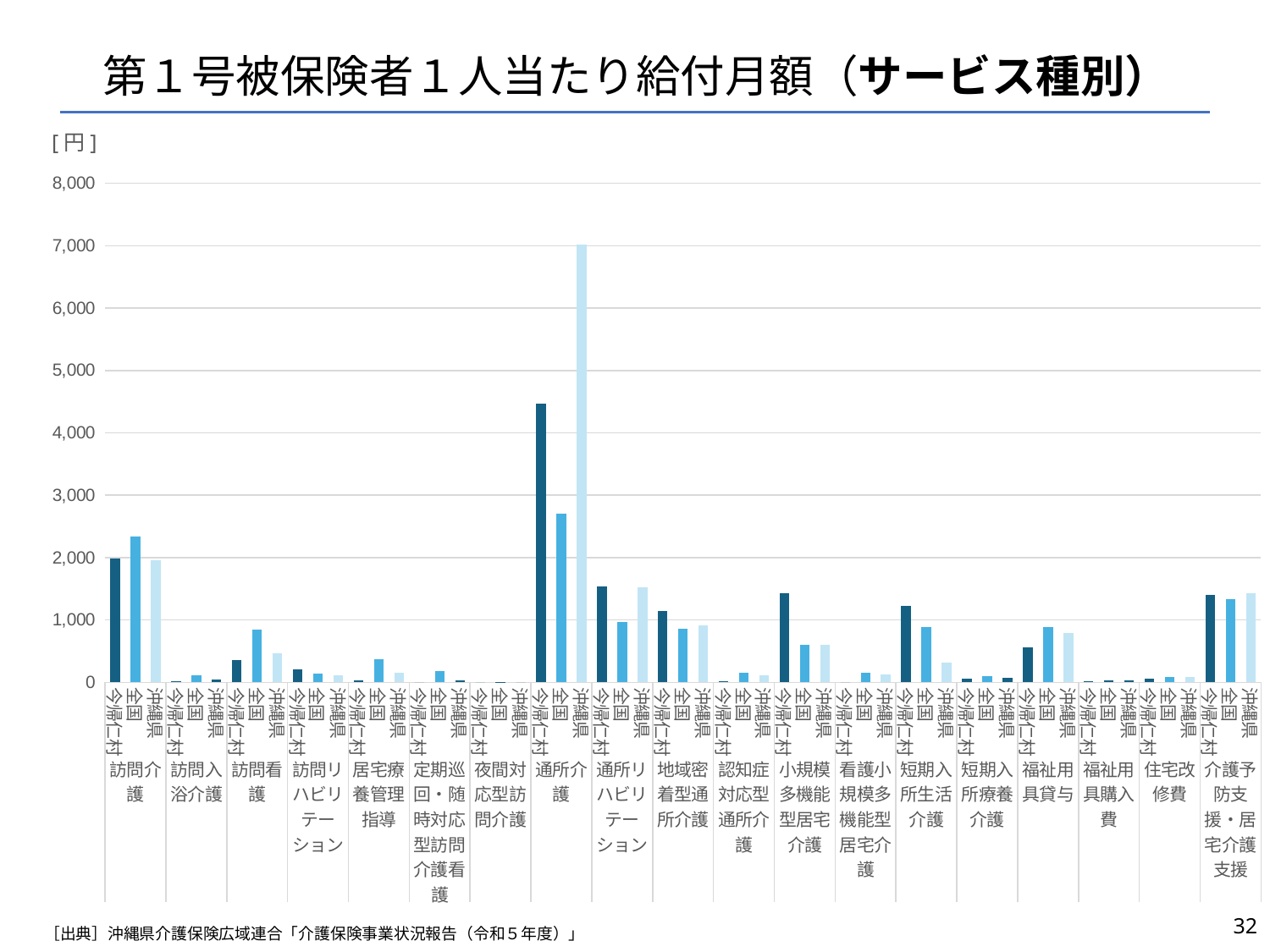
Is the value for 今帰仁村 in 通所介護 greater or less than 4,000? greater What kind of chart is shown on the slide? bar chart Is the value for 全国 in 訪問看護 greater or less than 1,000? less How many service categories are shown along the x axis of the chart? 19 Is the value for 沖縄県 in 通所介護 greater or less than 6,000? greater In 通所介護, which is larger: the value for 今帰仁村 or the value for 全国? 今帰仁村 What unit is shown at the top of the y axis? 円 What is the title of the chart on the slide? 第１号被保険者１人当たり給付月額（サービス種別） In 訪問介護, which is larger: the value for 全国 or the value for 沖縄県? 全国 Which bar in the chart is the highest overall? 沖縄県 for 通所介護